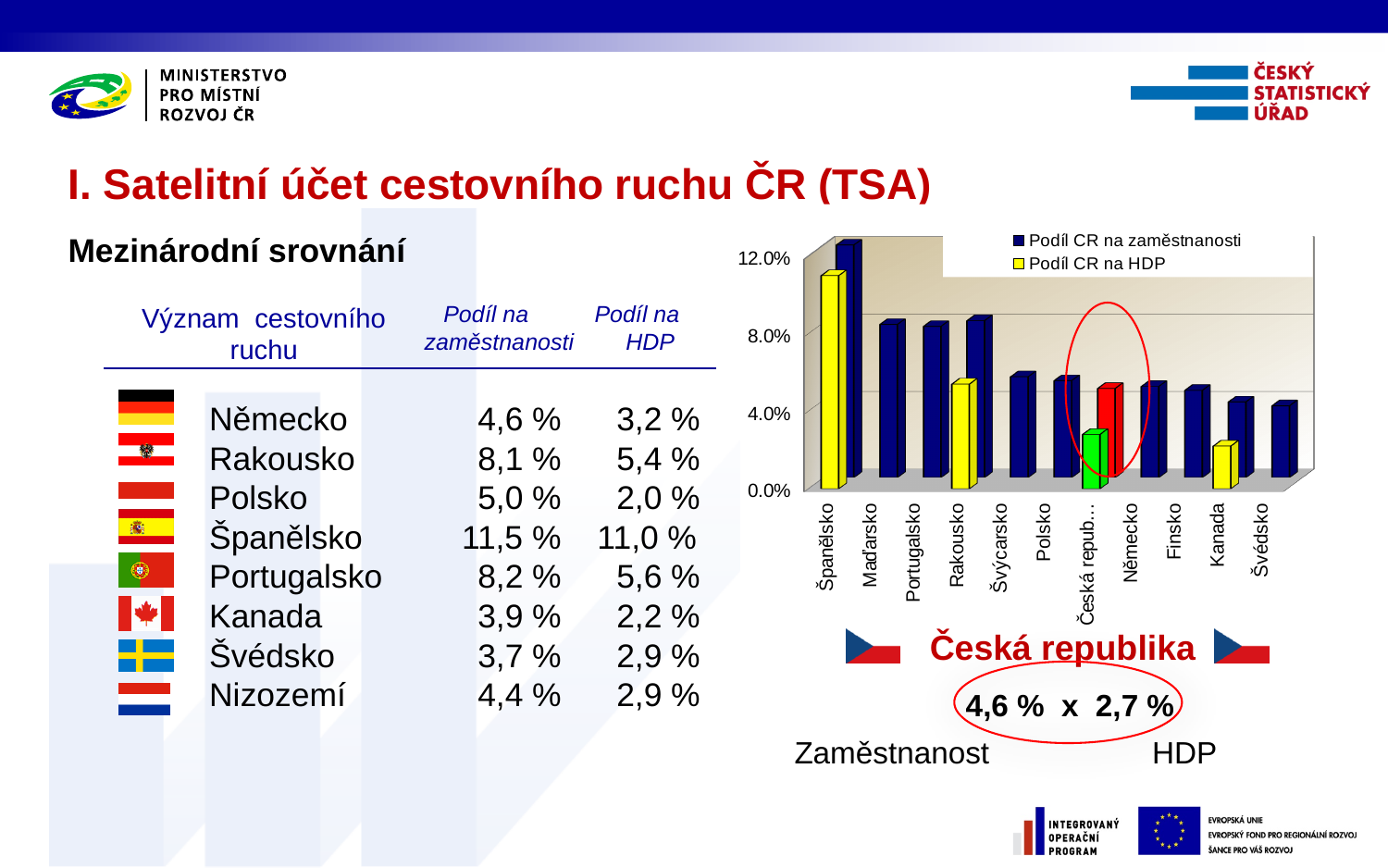
How many series does the chart legend list? 2 What is the Podíl CR na zaměstnanosti value for Česká republika shown on the slide? 4,6 % Is the Podíl CR na HDP value for Kanada greater or less than 4.0%? less What kind of chart is shown on the right side of the slide? bar chart Which country has the highest value for Podíl CR na zaměstnanosti in the chart? Španělsko Which is larger in the chart, the Podíl CR na zaměstnanosti value for Španělsko or for Německo? Španělsko What are the two series names listed in the chart legend? Podíl CR na zaměstnanosti; Podíl CR na HDP How many countries are shown on the x axis of the chart? 11 Do the Podíl CR na zaměstnanosti values generally rise or fall from left to right along the x axis? fall Is the Podíl CR na zaměstnanosti value for Španělsko greater or less than 8.0%? greater Is the Podíl CR na zaměstnanosti value for Rakousko greater or less than 4.0%? greater